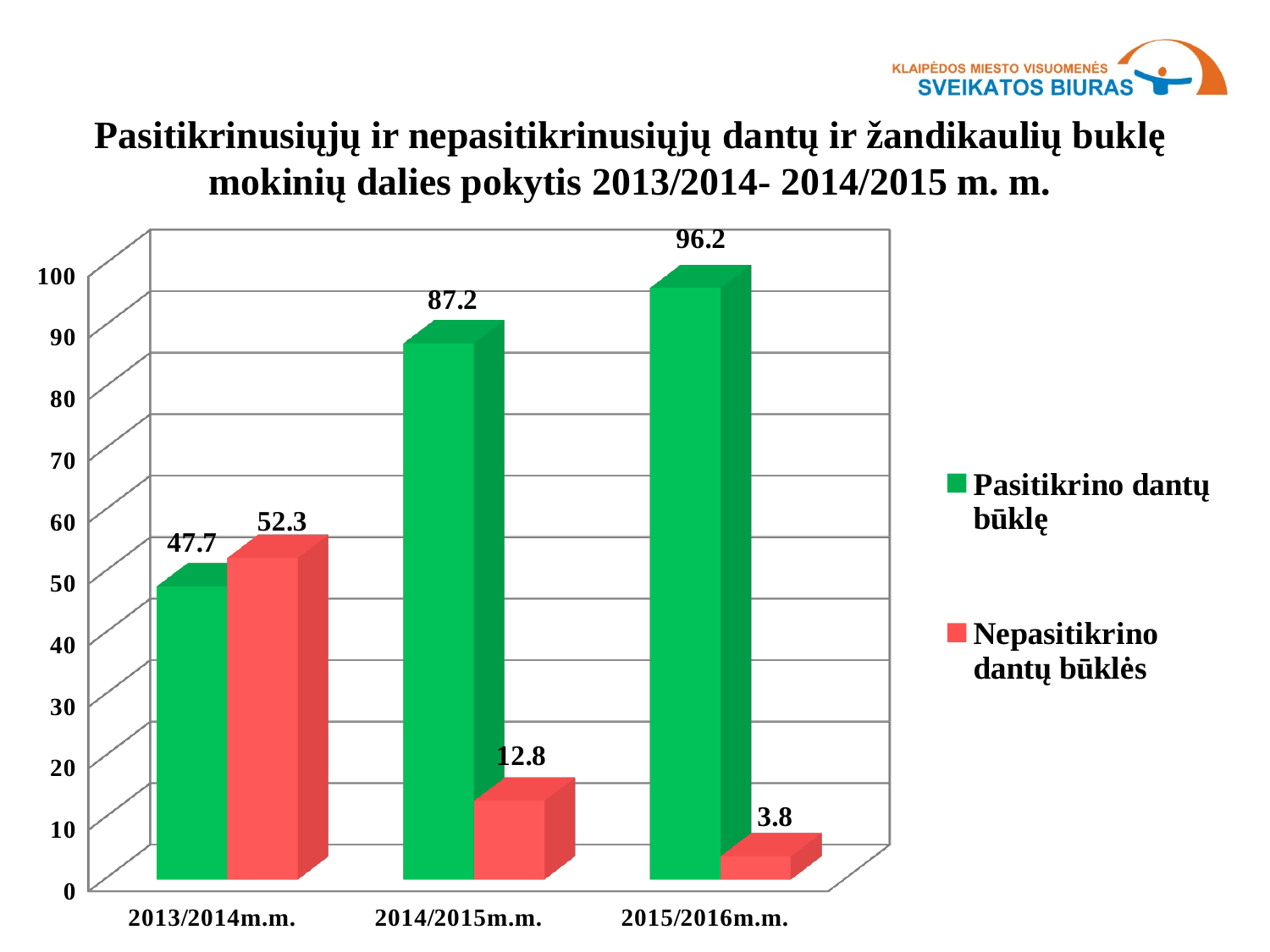
Is the value for "Pasitikrino dantų būklę" in 2014/2015m.m. greater or less than 80? greater What is the difference between the "Pasitikrino dantų būklę" values for 2015/2016m.m. and 2014/2015m.m.? 9 Does the value for "Nepasitikrino dantų būklės" rise or fall across the school years from 2013/2014m.m. to 2015/2016m.m.? fall What is the value for "Nepasitikrino dantų būklės" in 2014/2015m.m.? 12.8 In which school year is the value for "Pasitikrino dantų būklę" highest? 2015/2016m.m. Which is larger in 2013/2014m.m.: "Pasitikrino dantų būklę" or "Nepasitikrino dantų būklės"? Nepasitikrino dantų būklės What is the value for "Pasitikrino dantų būklę" in 2013/2014m.m.? 47.7 In which school year is the value for "Nepasitikrino dantų būklės" lowest? 2015/2016m.m. How many school years are shown on the x axis? 3 How many series does the legend list? 2 What kind of chart is shown on the slide? bar chart What is the value for "Nepasitikrino dantų būklės" in 2015/2016m.m.? 3.8